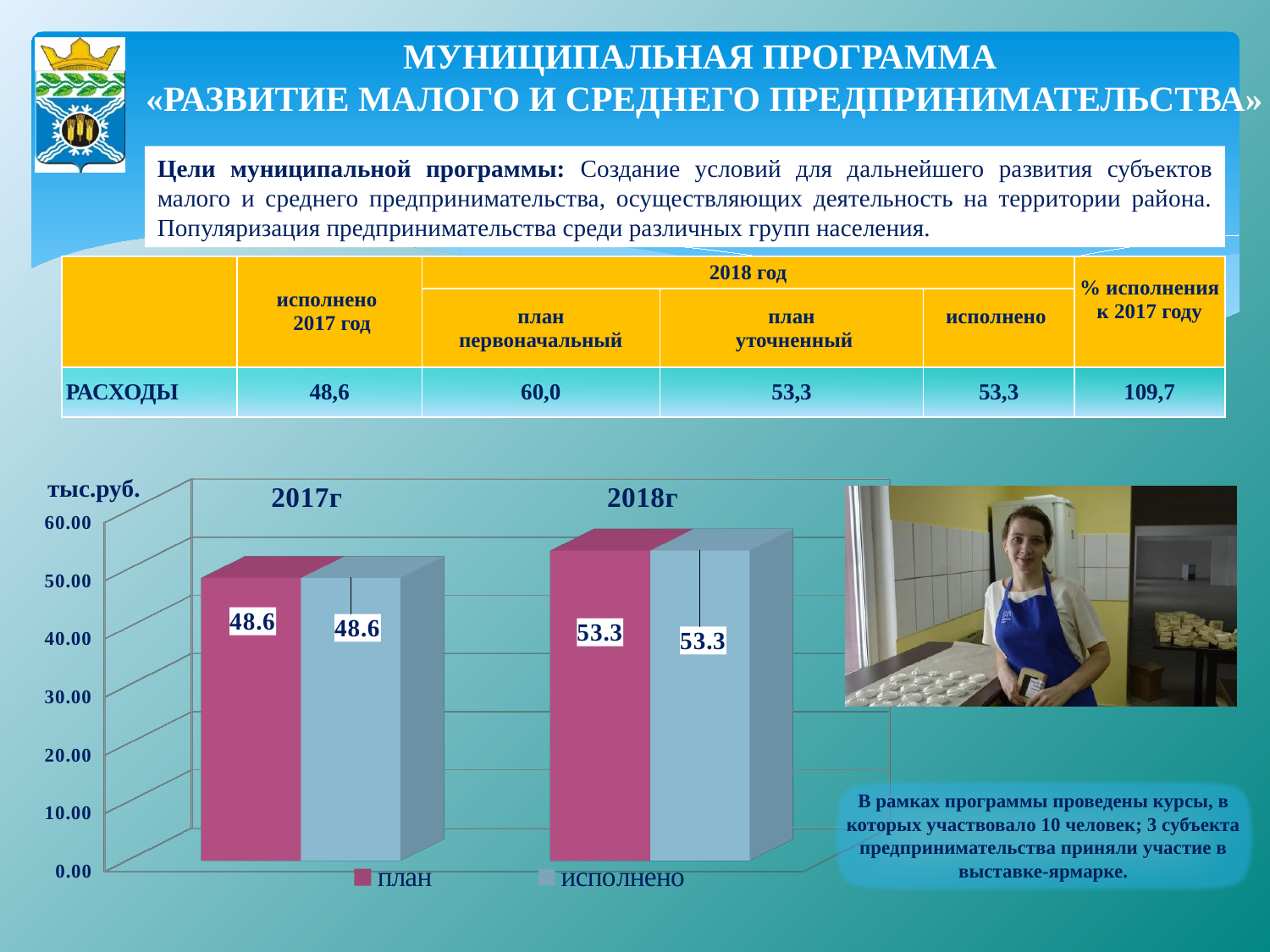
What type of chart is shown on the slide? bar chart How many year categories are shown on the x axis? 2 Do the план values rise or fall from 2017г to 2018г? rise What is the difference between the план values for 2018г and 2017г? 4.7 What is the value of план for 2018г? 53.3 Which year has the higher исполнено value, 2017г or 2018г? 2018г Is the value of исполнено for 2017г greater or less than 50.00? less What unit is shown at the top of the y axis? тыс.руб. What is the value of исполнено for 2018г? 53.3 What is the value of план for 2017г? 48.6 What is the value of исполнено for 2017г? 48.6 How many series does the legend list? 2